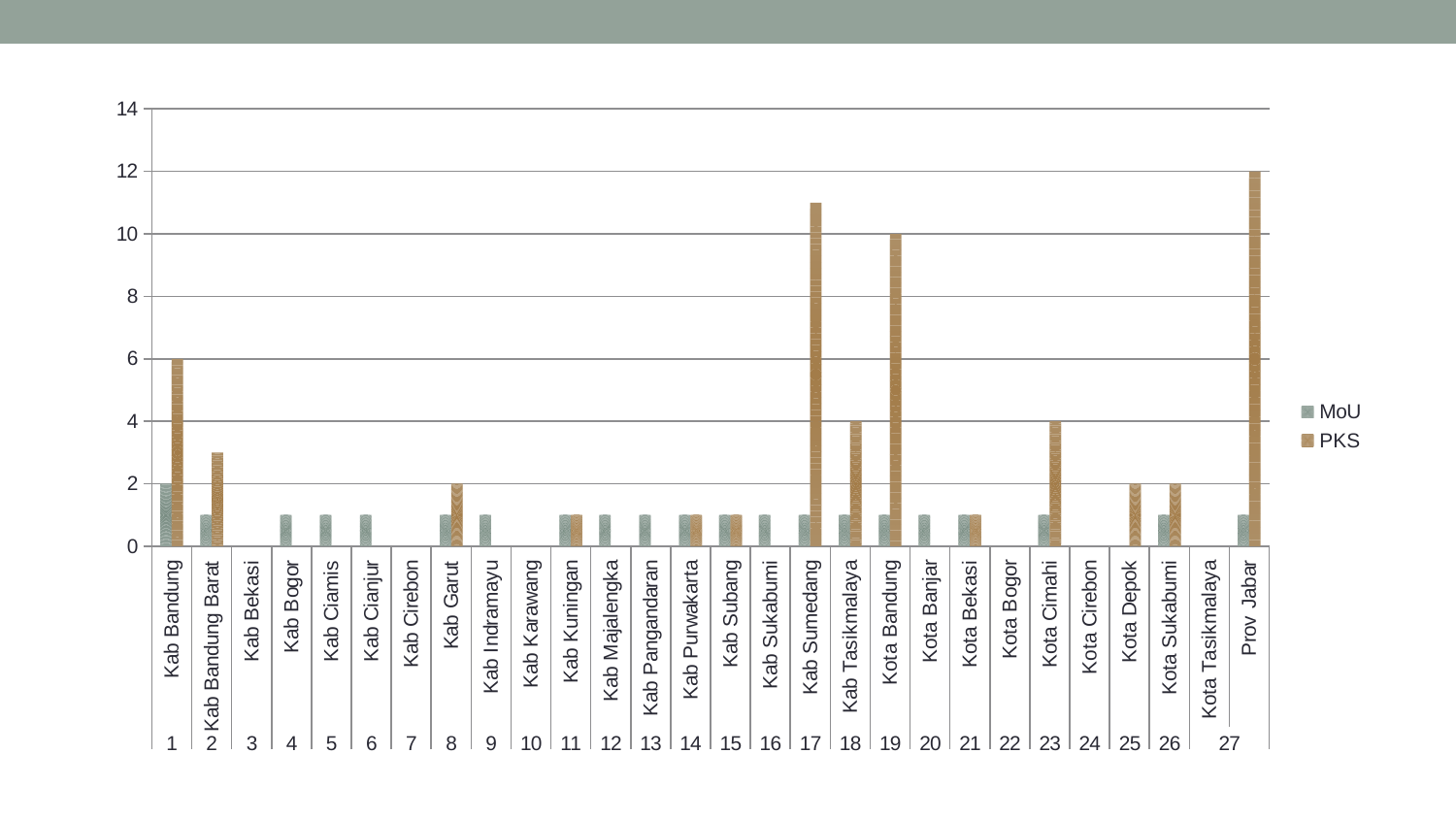
Is the PKS value for Kab Sumedang greater or less than 10? greater How many categories are shown on the x axis? 28 How many series does the legend list? 2 Which is larger, the PKS value for Prov Jabar or the PKS value for Kab Bandung? Prov Jabar What is the PKS value for Kota Bandung? 10 What is the difference between the PKS values for Prov Jabar and Kota Bandung? 2 Which category has the highest PKS value? Prov Jabar What is the PKS value for Kab Bandung? 6 What type of chart is shown on the slide? bar chart What is the MoU value for Kab Bandung? 2 What are the two series names shown in the legend? MoU and PKS What is the PKS value for Prov Jabar? 12